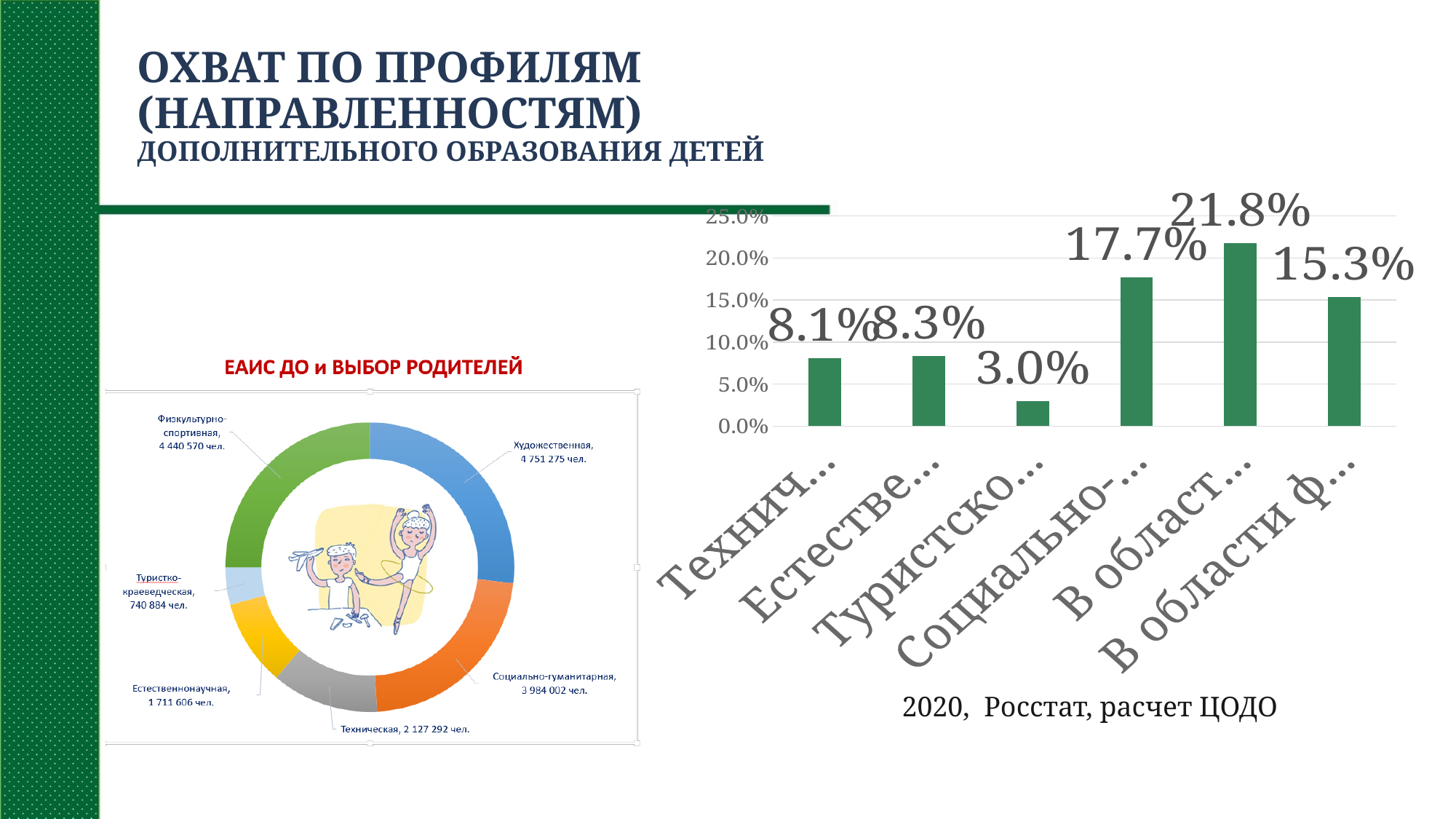
In the donut chart 'ЕАИС ДО и ВЫБОР РОДИТЕЛЕЙ', which is larger: Физкультурно-спортивная or Социально-гуманитарная? Физкультурно-спортивная In the bar chart on the right, what is the value of the third bar (label starting 'Туристско...')? 3.0% What kind of chart is the chart titled 'ЕАИС ДО и ВЫБОР РОДИТЕЛЕЙ'? donut (pie) chart In the bar chart on the right, is the value of the last bar (В области ф...) greater or less than 20.0%? less In the bar chart on the right, what is the difference between the fifth bar (21.8%) and the fourth bar (17.7%)? 4.1% In the bar chart on the right, which bar has the highest value? the fifth bar (В област...), 21.8% In the donut chart 'ЕАИС ДО и ВЫБОР РОДИТЕЛЕЙ', what is the value for Художественная? 4 751 275 чел. In the bar chart on the right, what is the value of the fifth bar (label starting 'В област...')? 21.8% What kind of chart is the chart on the right side of the slide? bar chart In the bar chart on the right, how many bars are plotted? 6 In the donut chart 'ЕАИС ДО и ВЫБОР РОДИТЕЛЕЙ', which category has the smallest value? Туристко-краеведческая In the bar chart on the right, which bar has the lowest value? the third bar (Туристско...), 3.0%